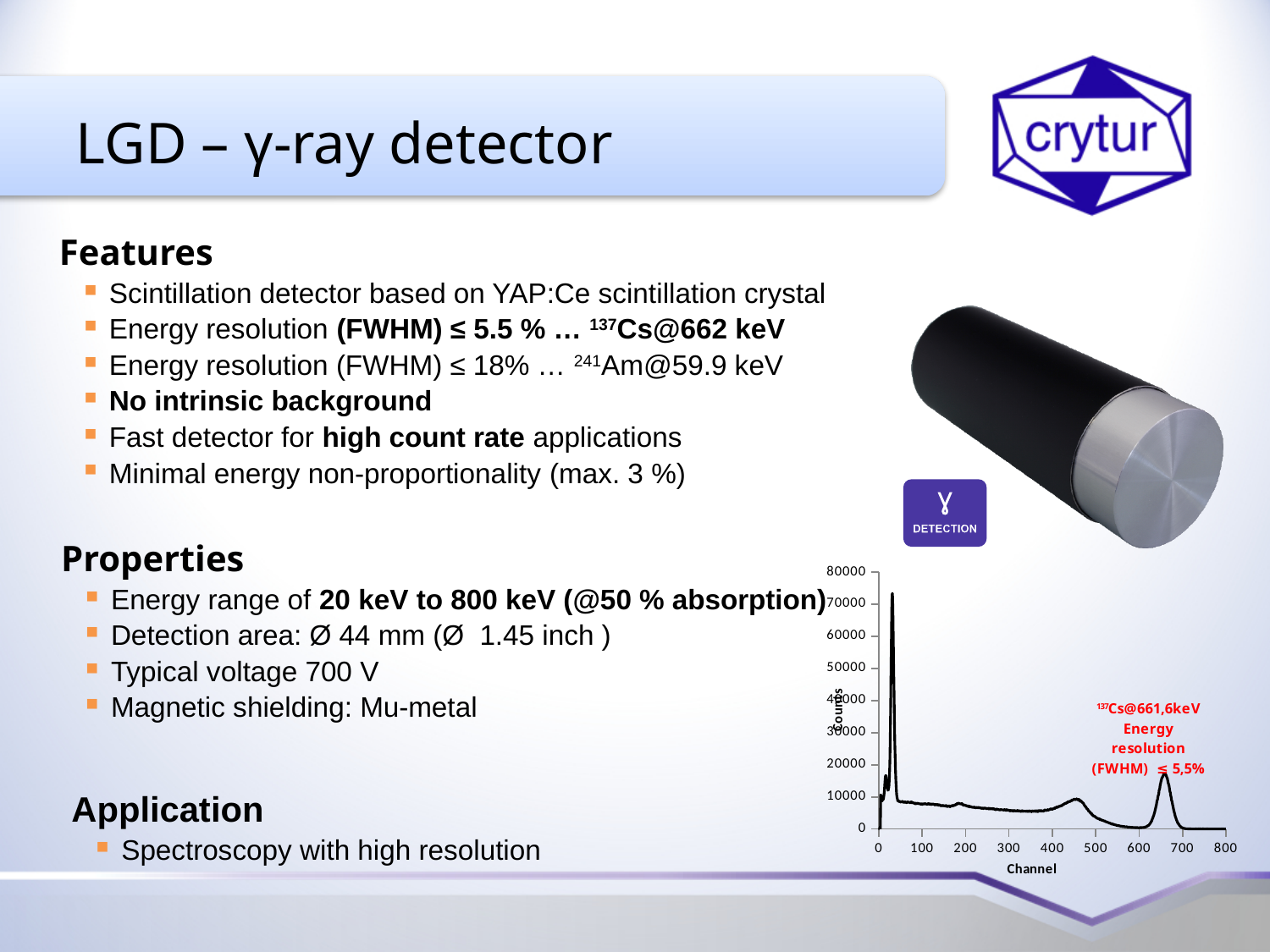
Is the count at channel 400 greater or less than 10000? less Is the peak count near channel 660 greater or less than 30000? less What is the highest tick value shown on the y axis of the spectrum chart? 80000 Between channel 500 and channel 600, do the counts rise or fall? fall What is the highest tick value shown on the x axis of the spectrum chart? 800 What is the label of the x axis of the spectrum chart? Channel Which is larger in the spectrum chart: the peak near channel 30 or the peak near channel 660? the peak near channel 30 What is the label of the y axis of the spectrum chart? Counts Is the count at channel 100 greater or less than 20000? less What kind of chart is shown at the bottom right of the slide? line chart